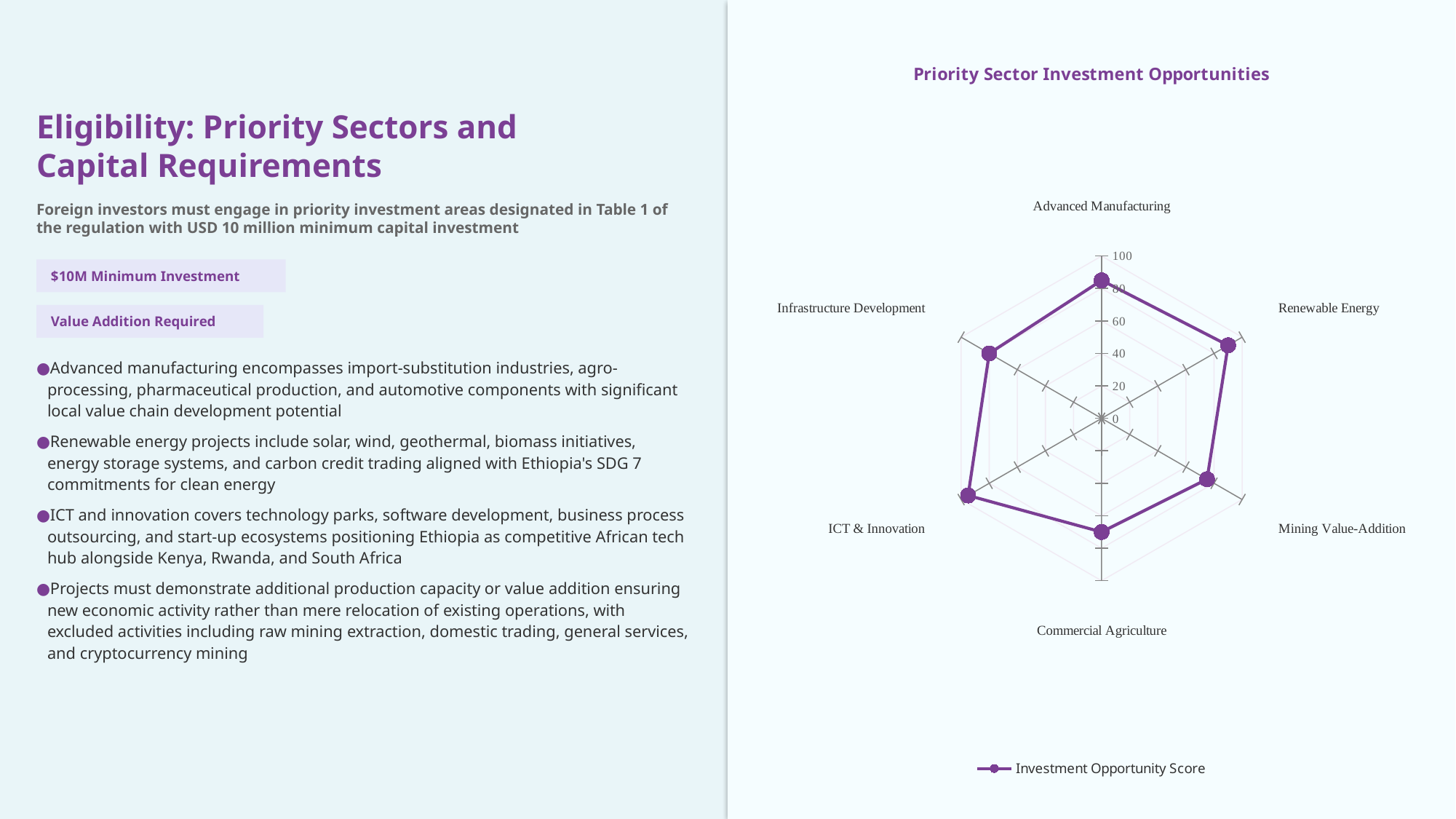
Is the Investment Opportunity Score for Renewable Energy greater or less than 80? greater Is the Investment Opportunity Score for Advanced Manufacturing greater or less than 80? greater Which has a higher Investment Opportunity Score, Renewable Energy or Commercial Agriculture? Renewable Energy Is the Investment Opportunity Score for ICT & Innovation greater or less than 80? greater What is the name of the series shown in the chart legend? Investment Opportunity Score What kind of chart is shown on the slide? Radar chart Which has a higher Investment Opportunity Score, ICT & Innovation or Commercial Agriculture? ICT & Innovation What is the title of the chart? Priority Sector Investment Opportunities How many series does the legend of the chart list? 1 How many sectors (categories) are plotted on the radar chart? 6